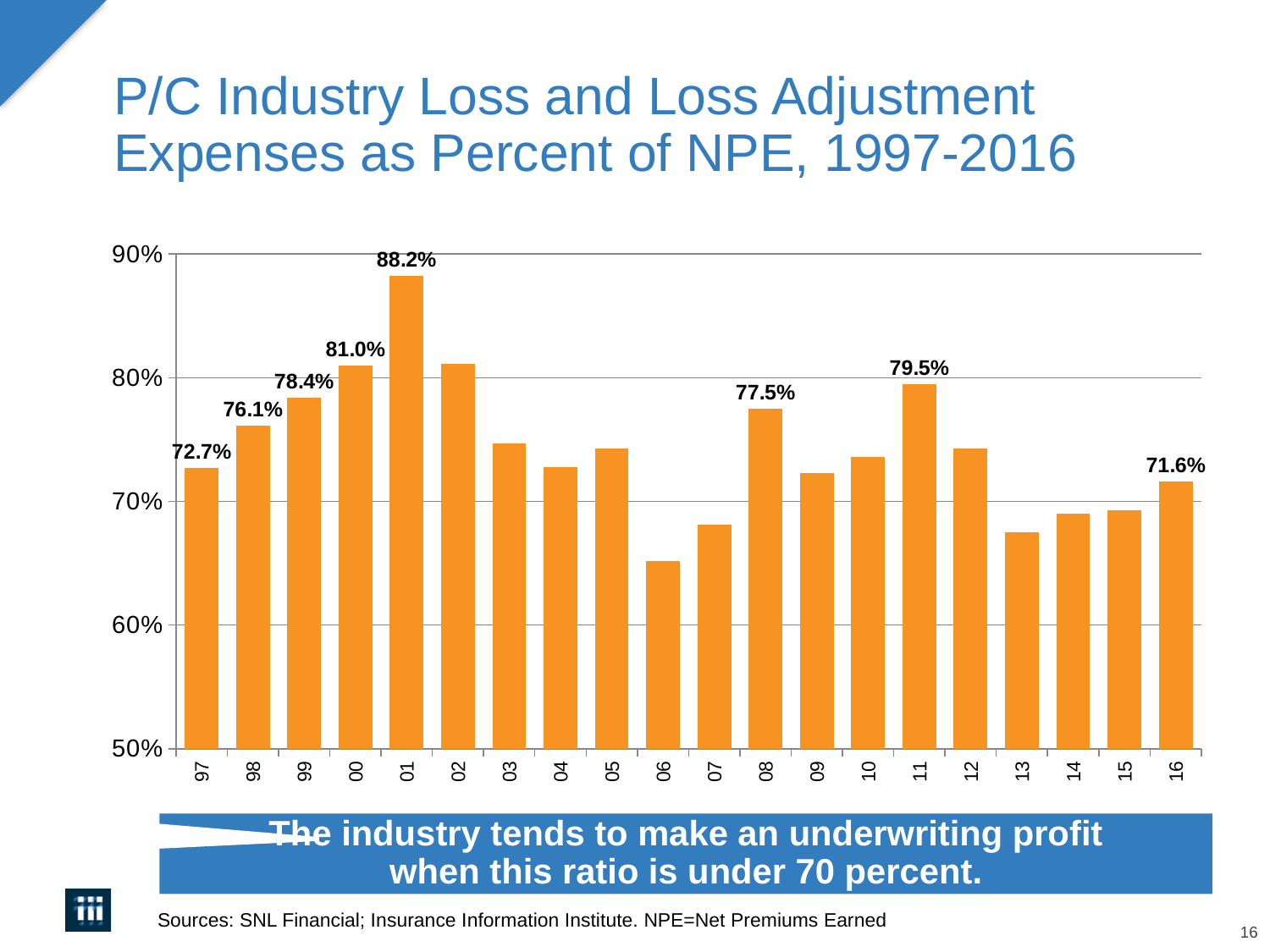
Is the value for 02 greater or less than 80%? greater Which year has the highest value? 01 What kind of chart is this? bar chart Is the value for 06 greater or less than 70%? less What is the value for 01? 88.2% Which year has the lowest value? 06 What is the difference between the values for 11 and 16? 7.9 percentage points Which is larger, the value for 08 or the value for 11? 11 What is the value for 16? 71.6% How many years are shown on the x axis? 20 What is the value for 08? 77.5% What is the difference between the values for 01 and 97? 15.5 percentage points